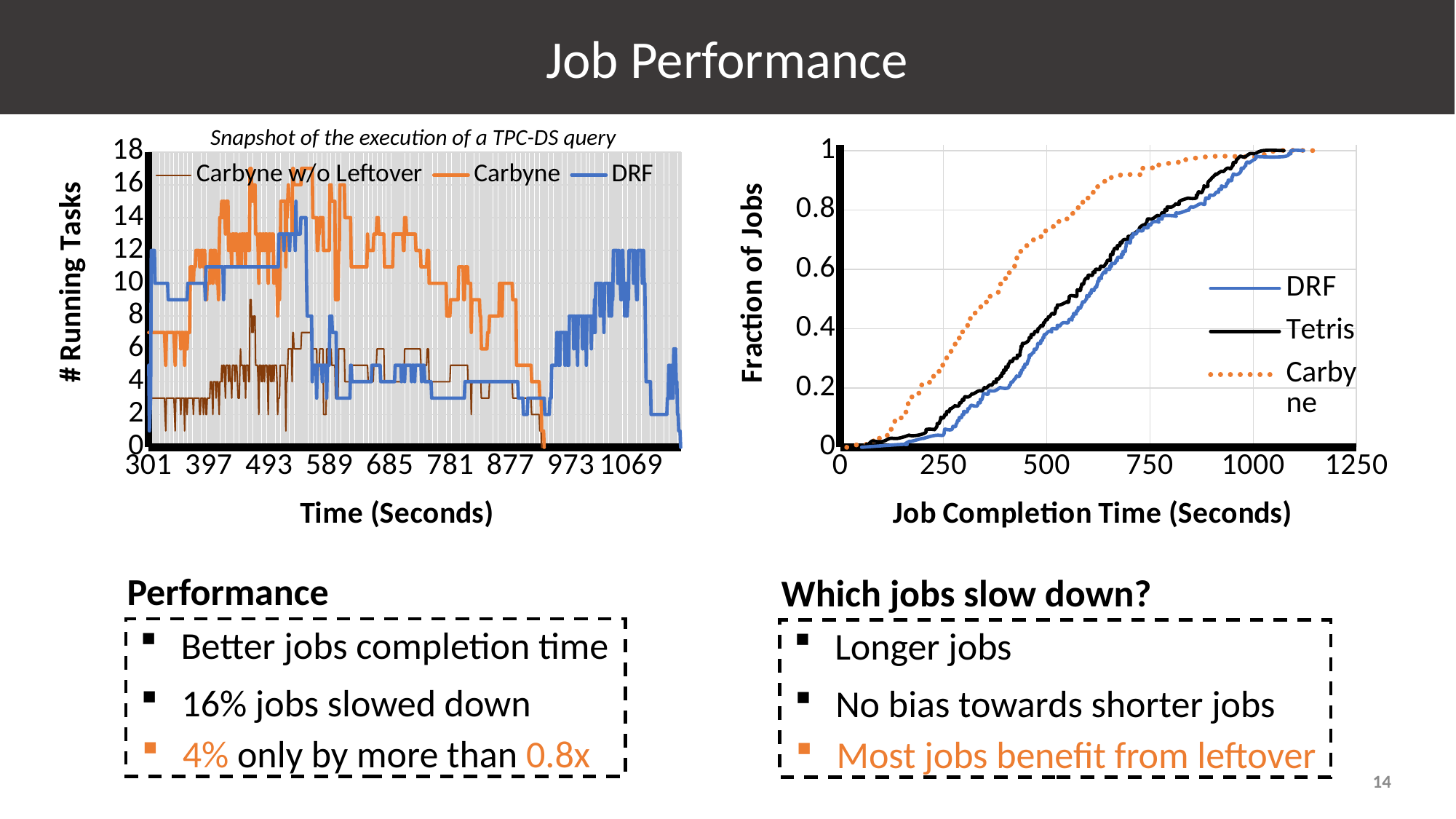
On the right chart (Job Completion Time), is the fraction of jobs for Carbyne at 500 seconds greater or less than 0.6? greater On the left chart (Snapshot of the execution of a TPC-DS query), how many series does the legend list? 3 On the left chart (Snapshot of the execution of a TPC-DS query), what kind of chart is it? Line chart On the left chart (Snapshot of the execution of a TPC-DS query), what is the first value shown on the x axis? 301 On the right chart (Job Completion Time), what is the x-axis label? Job Completion Time (Seconds) On the left chart (Snapshot of the execution of a TPC-DS query), what is the y-axis label? # Running Tasks On the left chart (Snapshot of the execution of a TPC-DS query), is the value for Carbyne w/o Leftover at around 685 seconds greater or less than 8? less On the right chart (Job Completion Time), at 500 seconds, which series has the higher fraction of jobs, Carbyne or DRF? Carbyne On the right chart (Job Completion Time), how many series does the legend list? 3 On the left chart (Snapshot of the execution of a TPC-DS query), is the value for Carbyne at around 493 seconds greater or less than 10? greater On the right chart (Job Completion Time), do the fraction of jobs values rise or fall as job completion time increases? rise